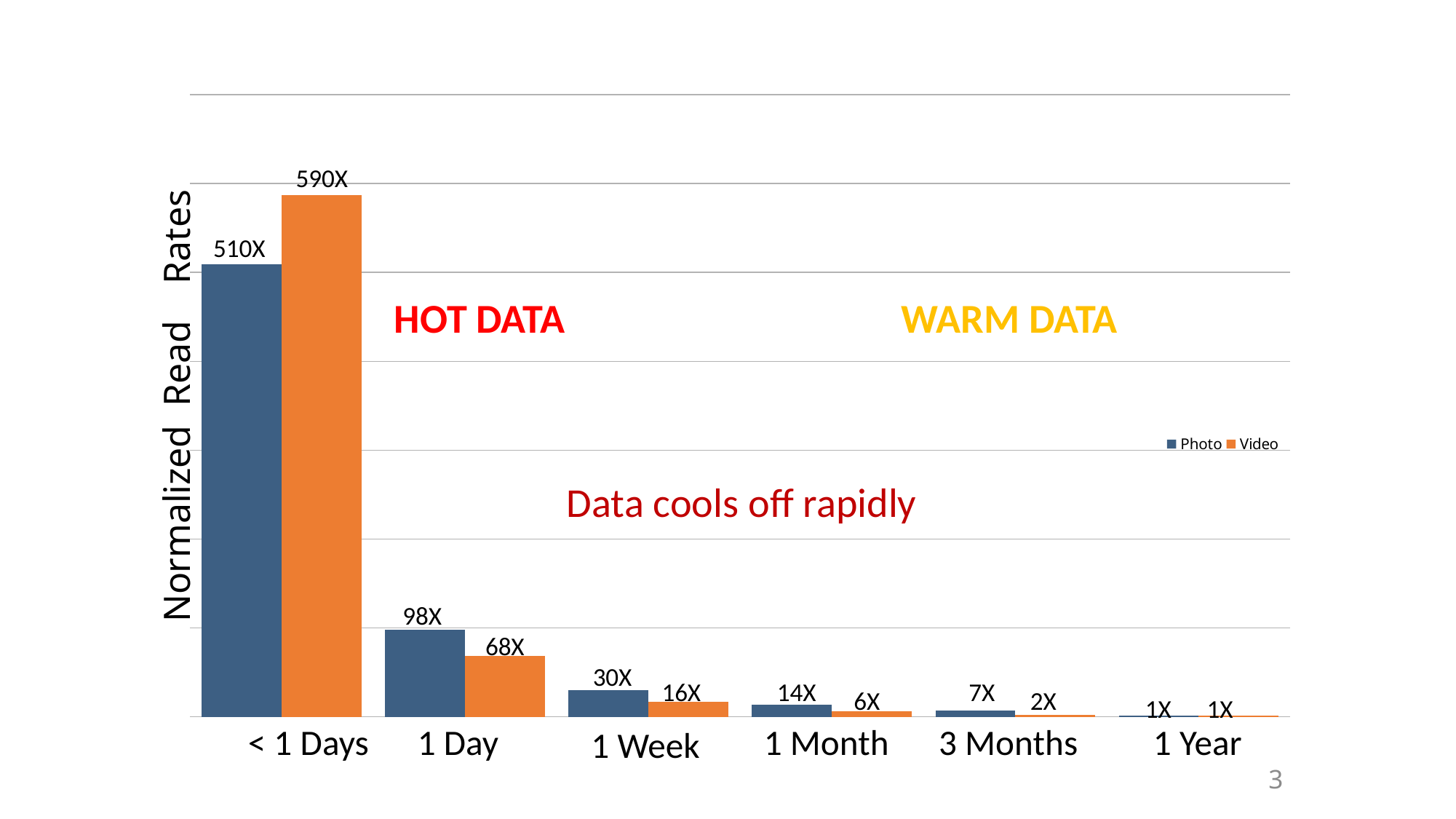
What is the difference between the Photo and Video read rates at 1 Day? 30X What kind of chart is shown on the slide? Bar chart How many series does the legend list? 2 What is the difference between the Video and Photo read rates at < 1 Days? 80X At 1 Month, which series has the larger read rate, Photo or Video? Photo Which age category has the highest Photo read rate? < 1 Days How many age categories are shown on the x axis? 6 What is the normalized read rate for Video at 1 Week? 16X What is the normalized read rate for Video at < 1 Days? 590X Which age category has the lowest Video read rate? 1 Year What is the normalized read rate for Photo at 1 Day? 98X What is the normalized read rate for Photo at 3 Months? 7X